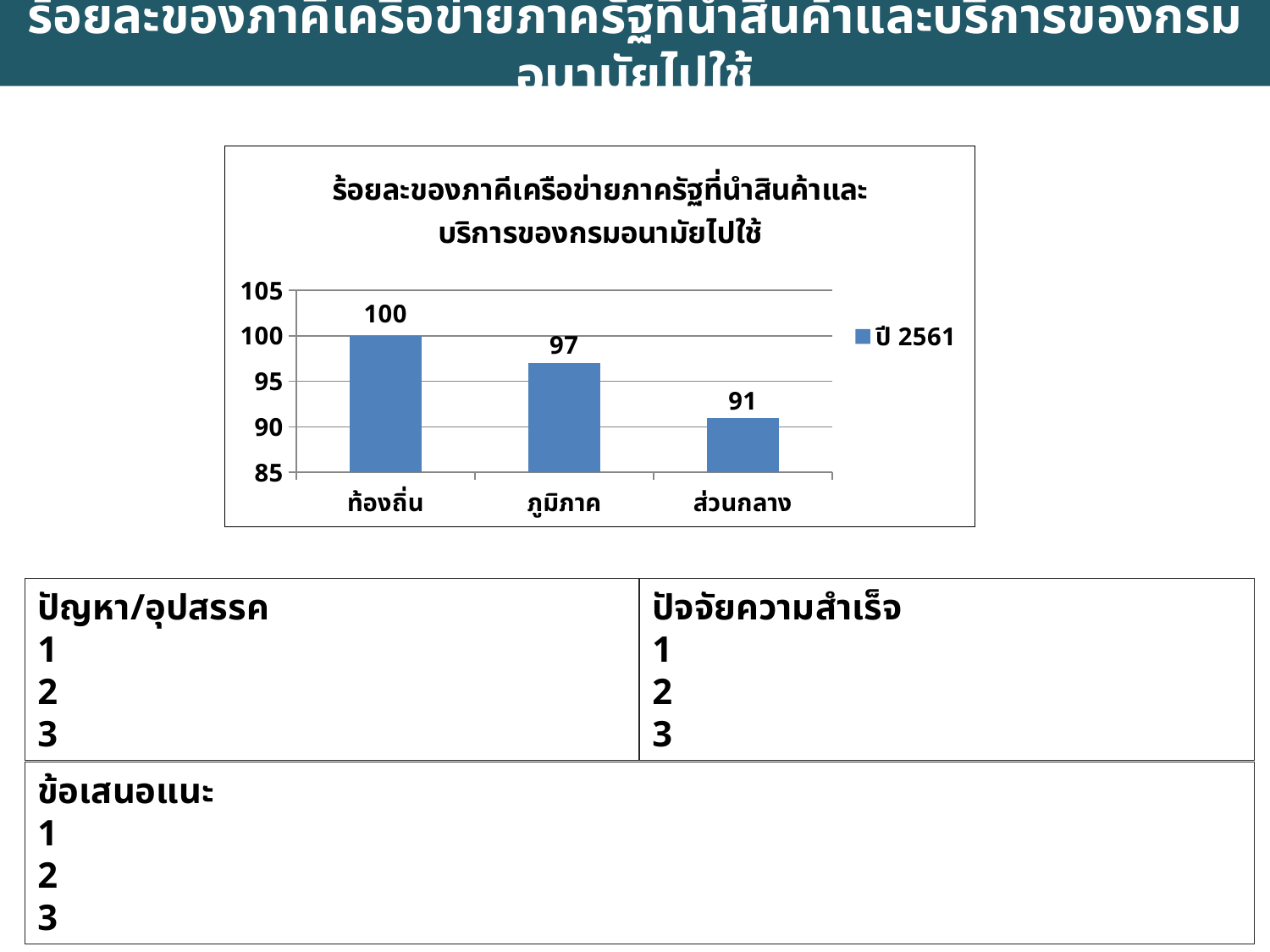
What is the difference between the values for ภูมิภาค and ส่วนกลาง? 6 What is the difference between the values for ท้องถิ่น and ส่วนกลาง? 9 How many categories are shown on the x axis? 3 Which is larger, the value for ภูมิภาค or the value for ส่วนกลาง? ภูมิภาค What is the legend entry for the series? ปี 2561 How many series does the legend list? 1 Which category has the lowest value? ส่วนกลาง What kind of chart is shown? bar chart What is the value for ภูมิภาค? 97 What is the value for ส่วนกลาง? 91 Which category has the highest value? ท้องถิ่น What is the value for ท้องถิ่น? 100